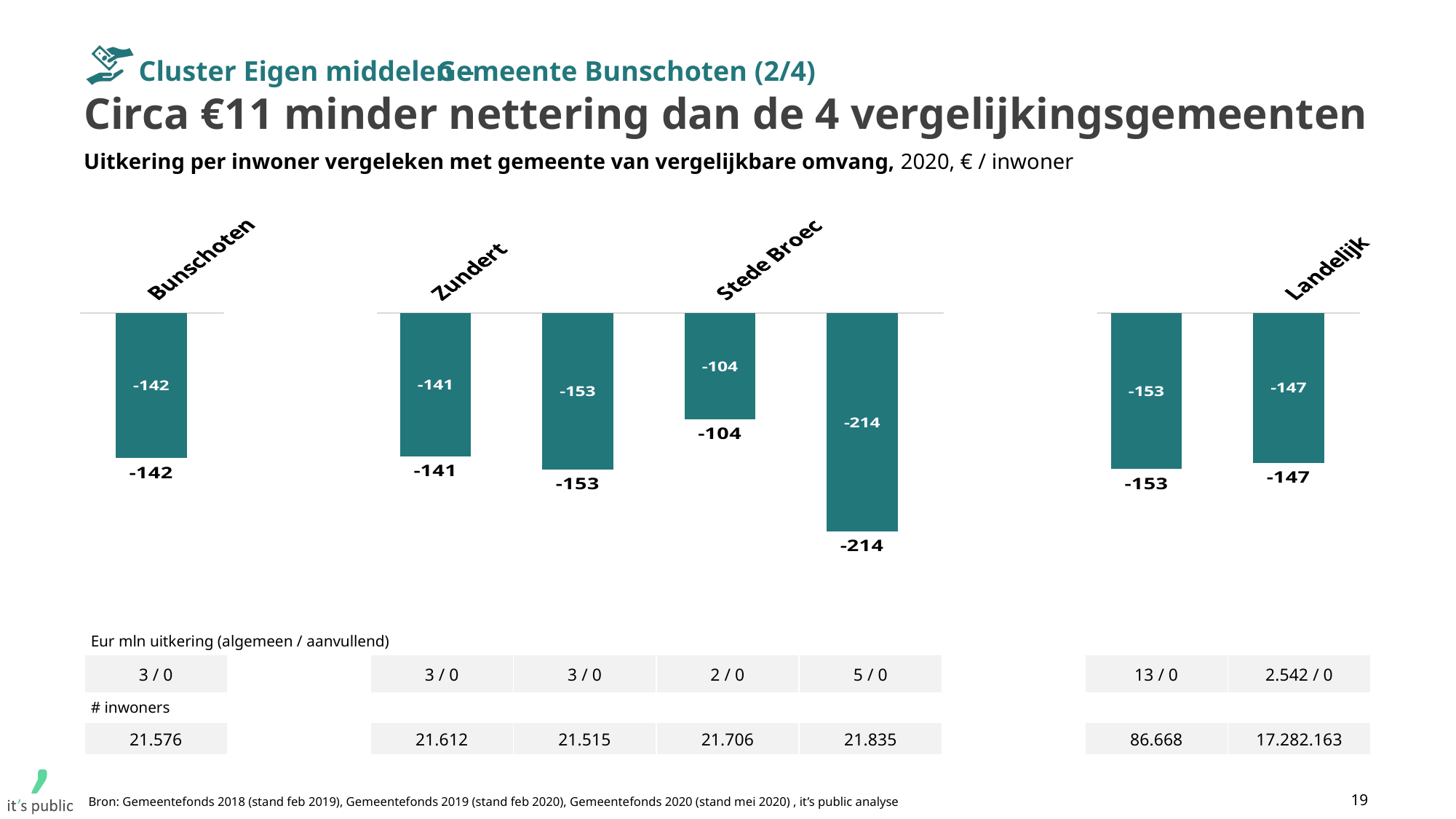
How many bars are shown on the chart? 7 Which labelled category has the highest (least negative) value? Stede Broec What is the value for Bunschoten? -142 Which has the lower value, Bunschoten or Landelijk? Landelijk What is the difference between the values for Stede Broec and Landelijk? 43 What is the value for Landelijk? -147 What is the difference between the values for Bunschoten and Landelijk? 5 What is the lowest value shown on the chart? -214 What colour are the bars in the chart? Teal What is the value for Stede Broec? -104 What is the value for Zundert? -141 What kind of chart is shown on the slide? Bar chart